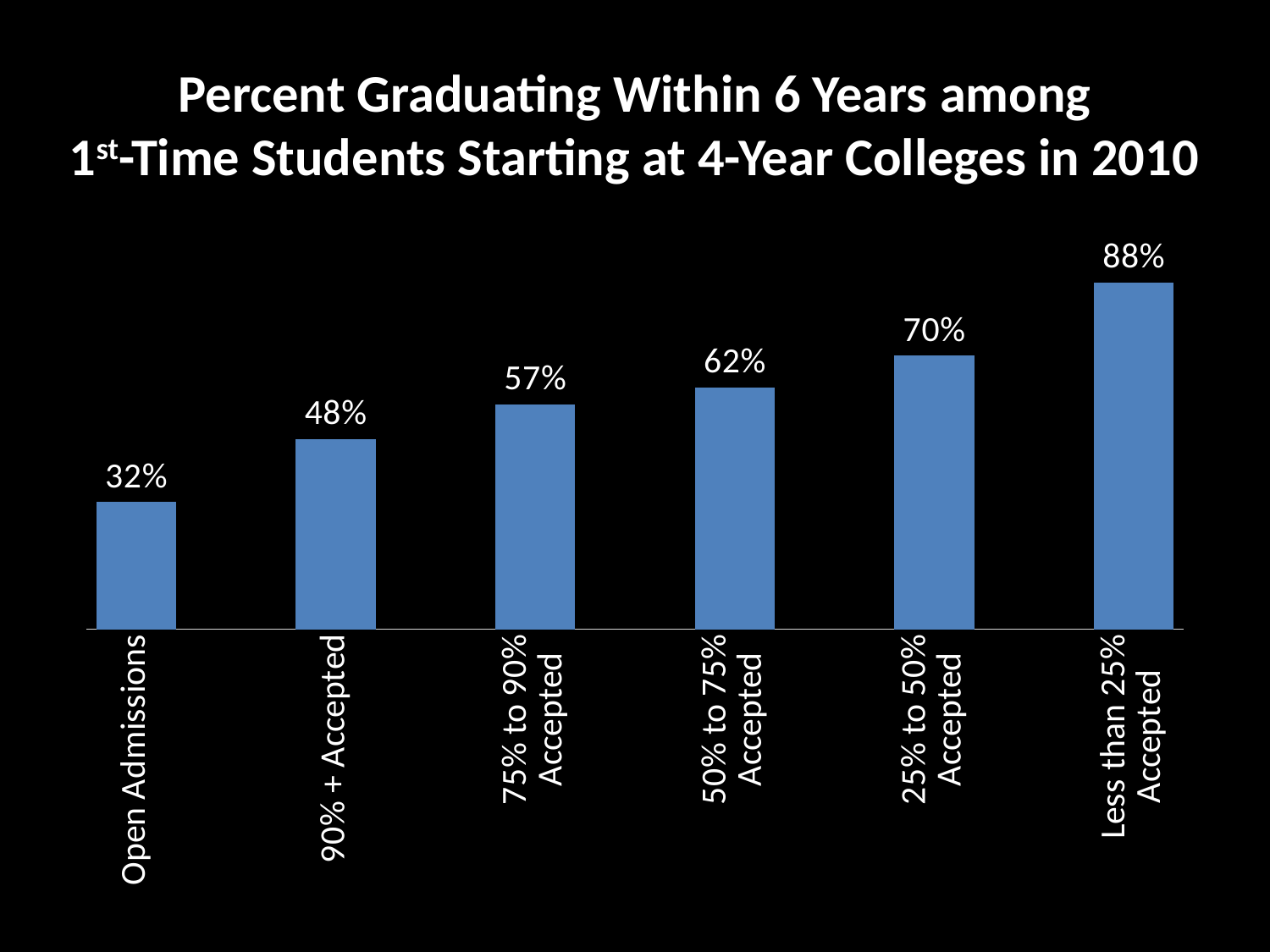
What is the difference between the values for 75% to 90% Accepted and 90% + Accepted? 9% What is the difference between the values for Less than 25% Accepted and Open Admissions? 56% How many categories are shown on the chart? 6 Which category has the lowest percent graduating within 6 years? Open Admissions What is the percent graduating within 6 years for Open Admissions colleges? 32% What is the value for colleges with 25% to 50% Accepted? 70% Which is larger, the value for 90% + Accepted or the value for 50% to 75% Accepted? 50% to 75% Accepted What kind of chart is shown on the slide? Bar chart Do the values rise or fall moving from left to right along the x axis? Rise Which category has the highest percent graduating within 6 years? Less than 25% Accepted What is the value for colleges with 50% to 75% Accepted? 62% What is the title of the chart? Percent Graduating Within 6 Years among 1st-Time Students Starting at 4-Year Colleges in 2010